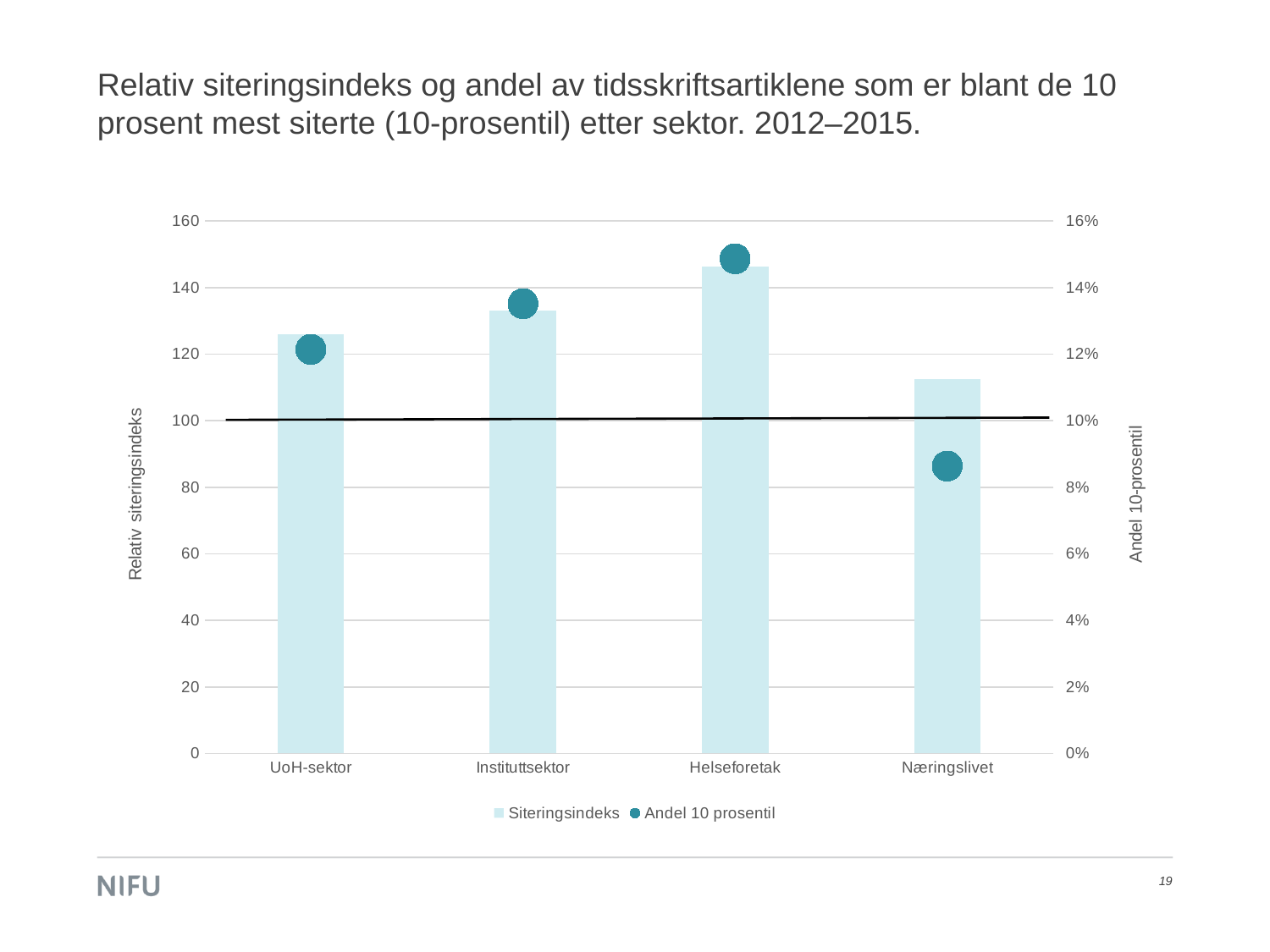
Which sector has the lowest Andel 10 prosentil marker? Næringslivet Is the Siteringsindeks value for Helseforetak greater or less than 140? greater How many sectors are shown on the x axis? 4 Which has the larger Siteringsindeks, UoH-sektor or Instituttsektor? Instituttsektor Is the Siteringsindeks value for Næringslivet greater or less than 100? greater Which sector has the highest Siteringsindeks bar? Helseforetak How many series does the legend list? 2 Which sector has the highest Andel 10 prosentil marker? Helseforetak Which sector has the lowest Siteringsindeks bar? Næringslivet What is the title of the right-hand vertical axis? Andel 10-prosentil Is the Andel 10 prosentil value for Næringslivet greater or less than 10%? less